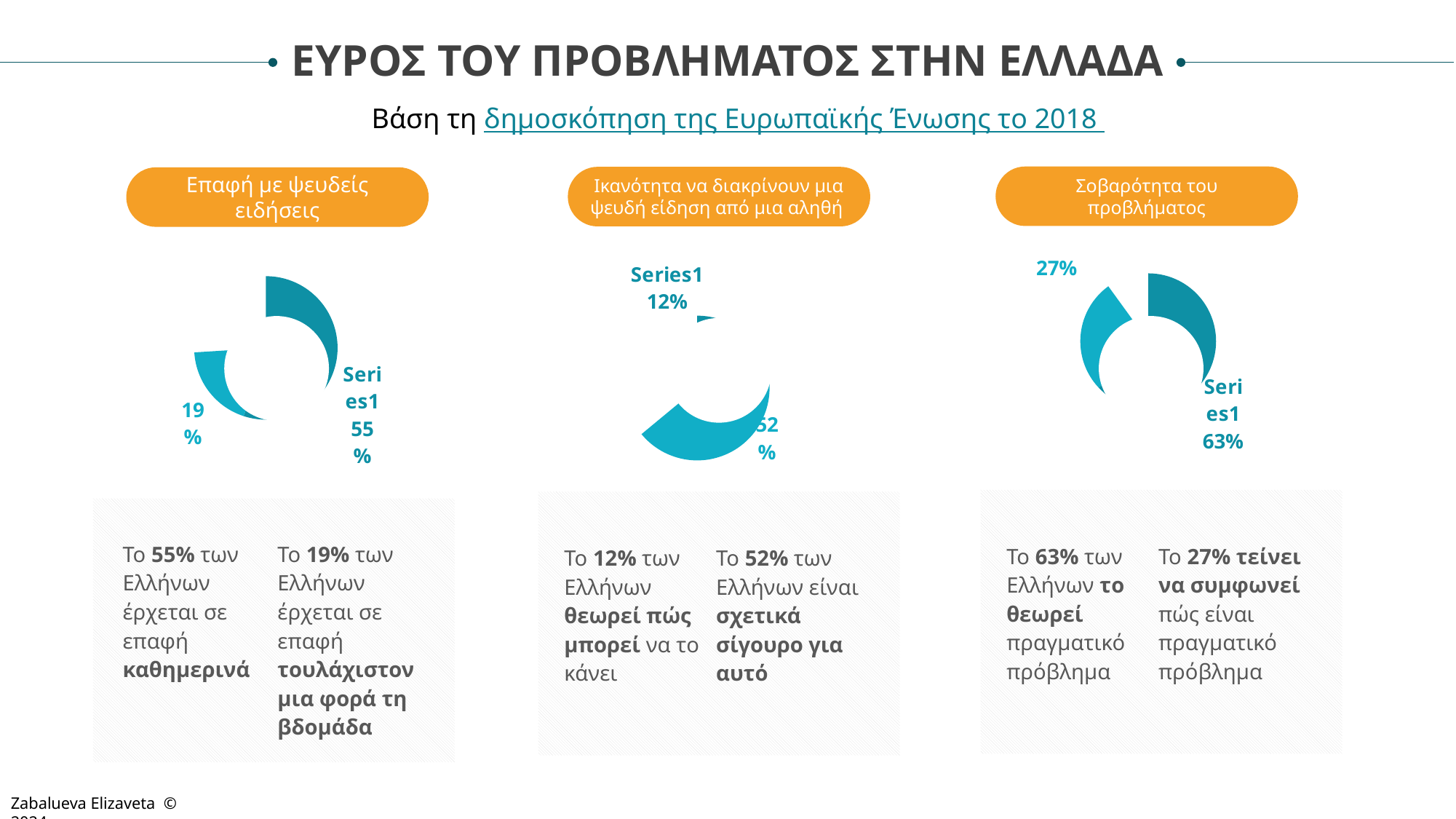
On the left chart under 'Επαφή με ψευδείς ειδήσεις', what is the difference between the two labelled slices? 36% On the middle chart under 'Ικανότητα να διακρίνουν μια ψευδή είδηση από μια αληθή', what is the value of the larger slice? 52% How many charts are shown on the slide? 3 On the right chart under 'Σοβαρότητα του προβλήματος', what is the difference between the two labelled slices? 36% How many labelled slices does the left chart under 'Επαφή με ψευδείς ειδήσεις' have? 2 On the right chart under 'Σοβαρότητα του προβλήματος', what is the value of the smaller slice? 27% On the middle chart under 'Ικανότητα να διακρίνουν μια ψευδή είδηση από μια αληθή', which labelled value is larger, 12% or 52%? 52% On the left chart under 'Επαφή με ψευδείς ειδήσεις', what is the value of the smaller slice? 19% On the middle chart under 'Ικανότητα να διακρίνουν μια ψευδή είδηση από μια αληθή', what value is labelled for Series1 at the top? 12% What kind of chart is shown under 'Σοβαρότητα του προβλήματος'? pie chart On the right chart under 'Σοβαρότητα του προβλήματος', what is the value of the larger slice? 63% On the left chart under 'Επαφή με ψευδείς ειδήσεις', what is the value of the larger slice? 55%